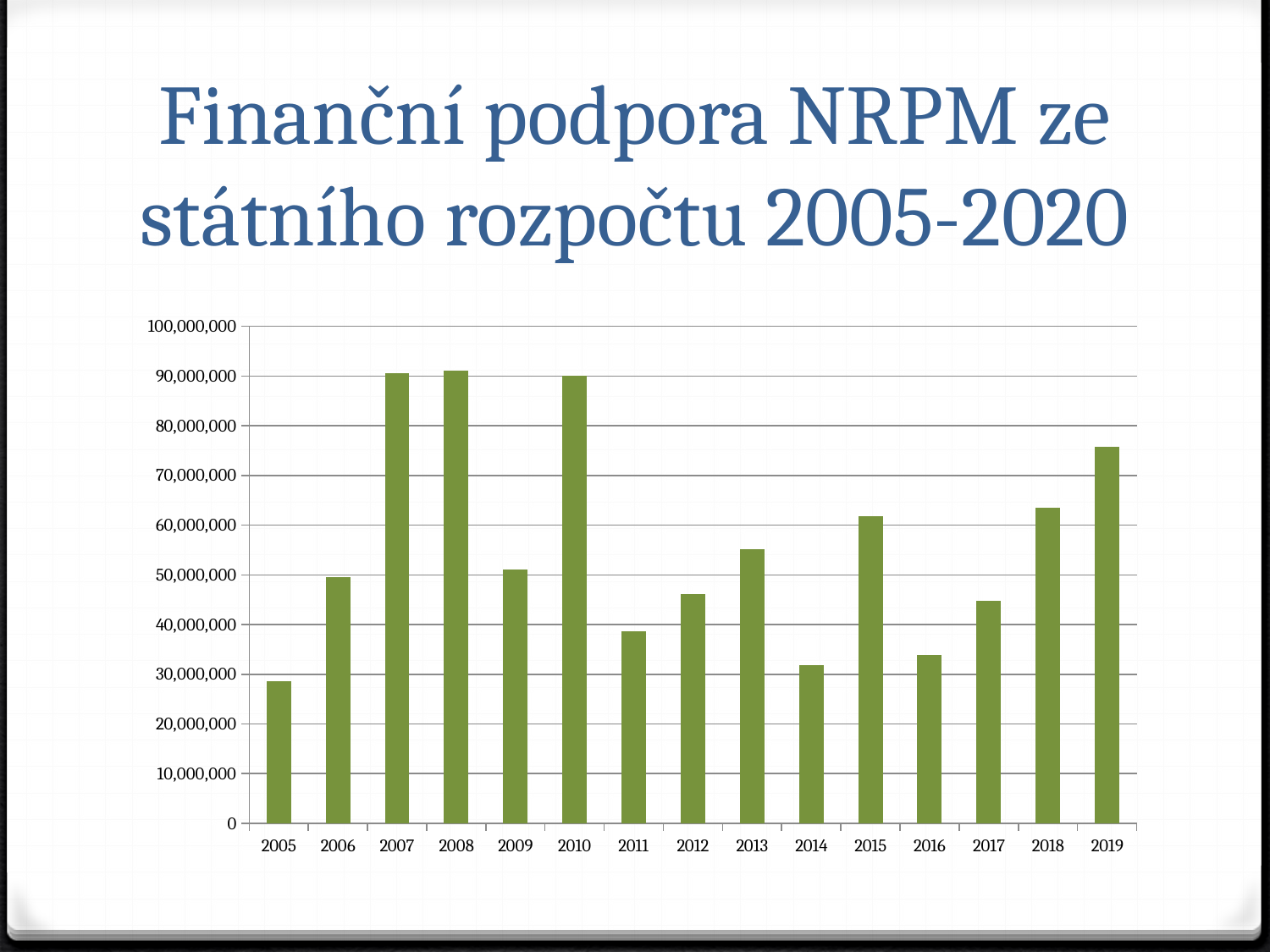
Which year has the larger value, 2017 or 2018? 2018 Is the value for 2007 greater or less than 80,000,000? greater What is the title of the slide containing the chart? Finanční podpora NRPM ze státního rozpočtu 2005-2020 Which year has the lowest value in the chart? 2005 Is the value for 2019 greater or less than 70,000,000? greater Do the values rise or fall from 2016 to 2019? rise Is the value for 2016 greater or less than 40,000,000? less How many years are shown on the x axis of the chart? 15 Which year has the larger value, 2012 or 2013? 2013 What kind of chart is shown on the slide? bar chart